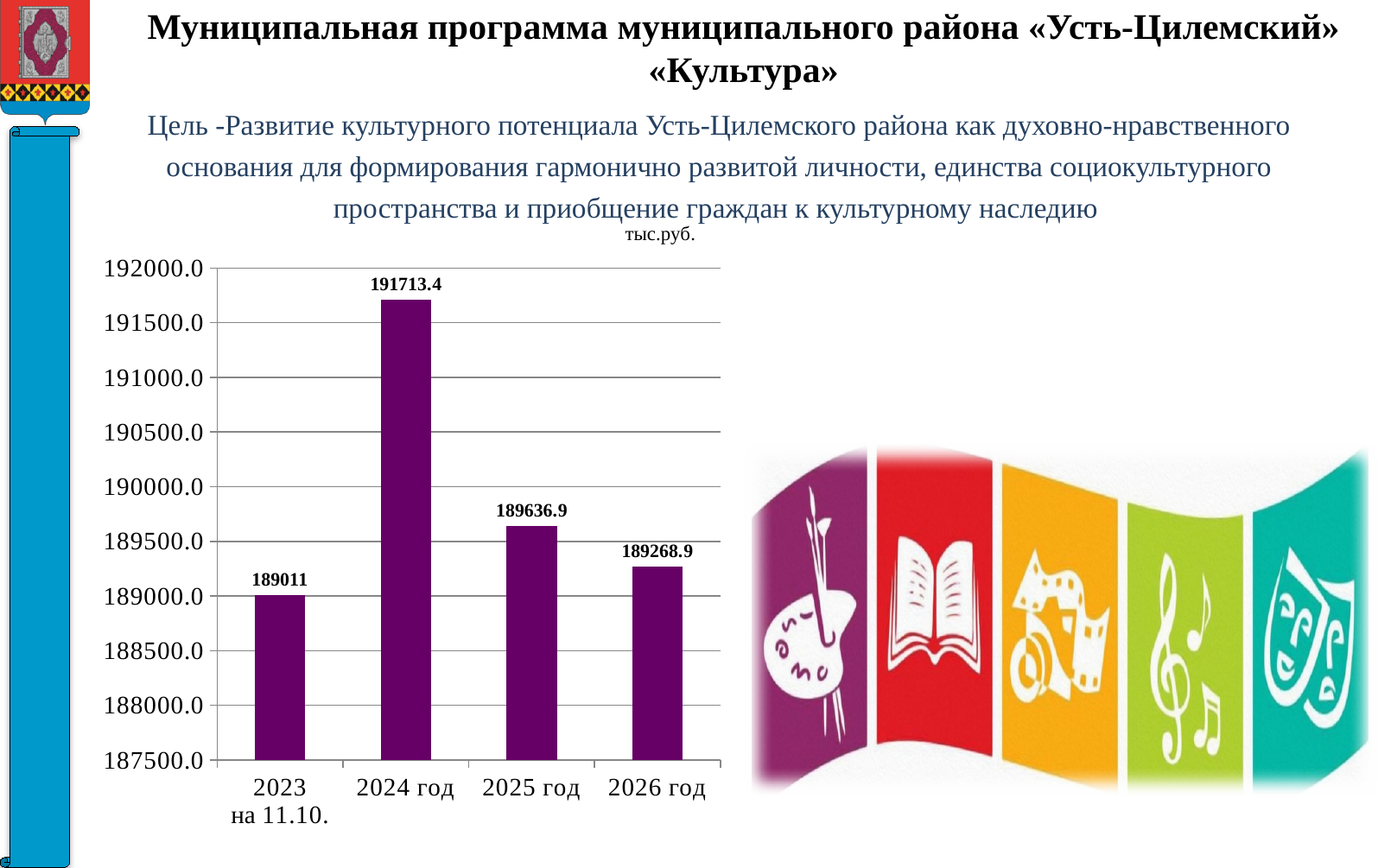
What is the difference between the values for 2025 год and 2026 год? 368.0 What unit label is shown above the chart? тыс.руб. Which category has the lowest value? 2023 на 11.10. What type of chart is shown on the slide? bar chart Which is larger, the value for 2025 год or the value for 2026 год? 2025 год What is the value for 2026 год? 189268.9 What is the value for 2025 год? 189636.9 How many bars (categories) does the chart show? 4 Which category has the highest value? 2024 год What is the difference between the values for 2024 год and 2023 на 11.10.? 2702.4 What is the value for 2024 год? 191713.4 What is the value for 2023 на 11.10.? 189011